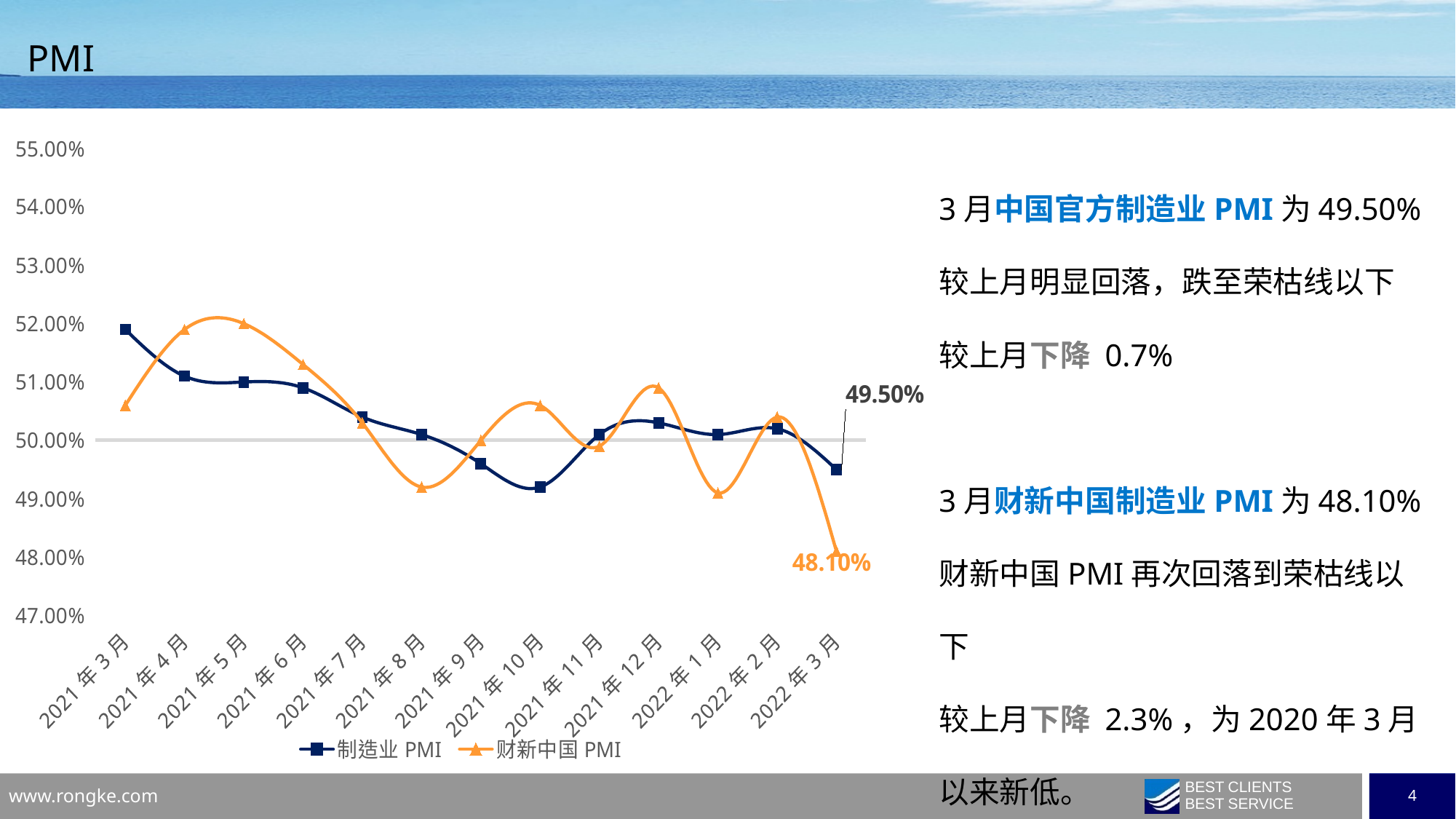
In which month does 财新中国 PMI reach its lowest value? 2022年3月 For 2021年3月, which series has the higher value, 制造业 PMI or 财新中国 PMI? 制造业 PMI Is the value of 财新中国 PMI for 2021年8月 greater or less than 50.00%? less Does 财新中国 PMI rise or fall from 2022年2月 to 2022年3月? fall What is the value of 制造业 PMI for 2022年3月? 49.50% Is the value of 制造业 PMI for 2021年3月 greater or less than 51.00%? greater What kind of chart is shown on the slide? line chart What is the value of 财新中国 PMI for 2022年3月? 48.10% What is the difference between 制造业 PMI and 财新中国 PMI for 2022年3月? 1.40% For 2022年3月, which series has the higher value, 制造业 PMI or 财新中国 PMI? 制造业 PMI How many months are plotted on the x axis? 13 How many series does the legend list? 2